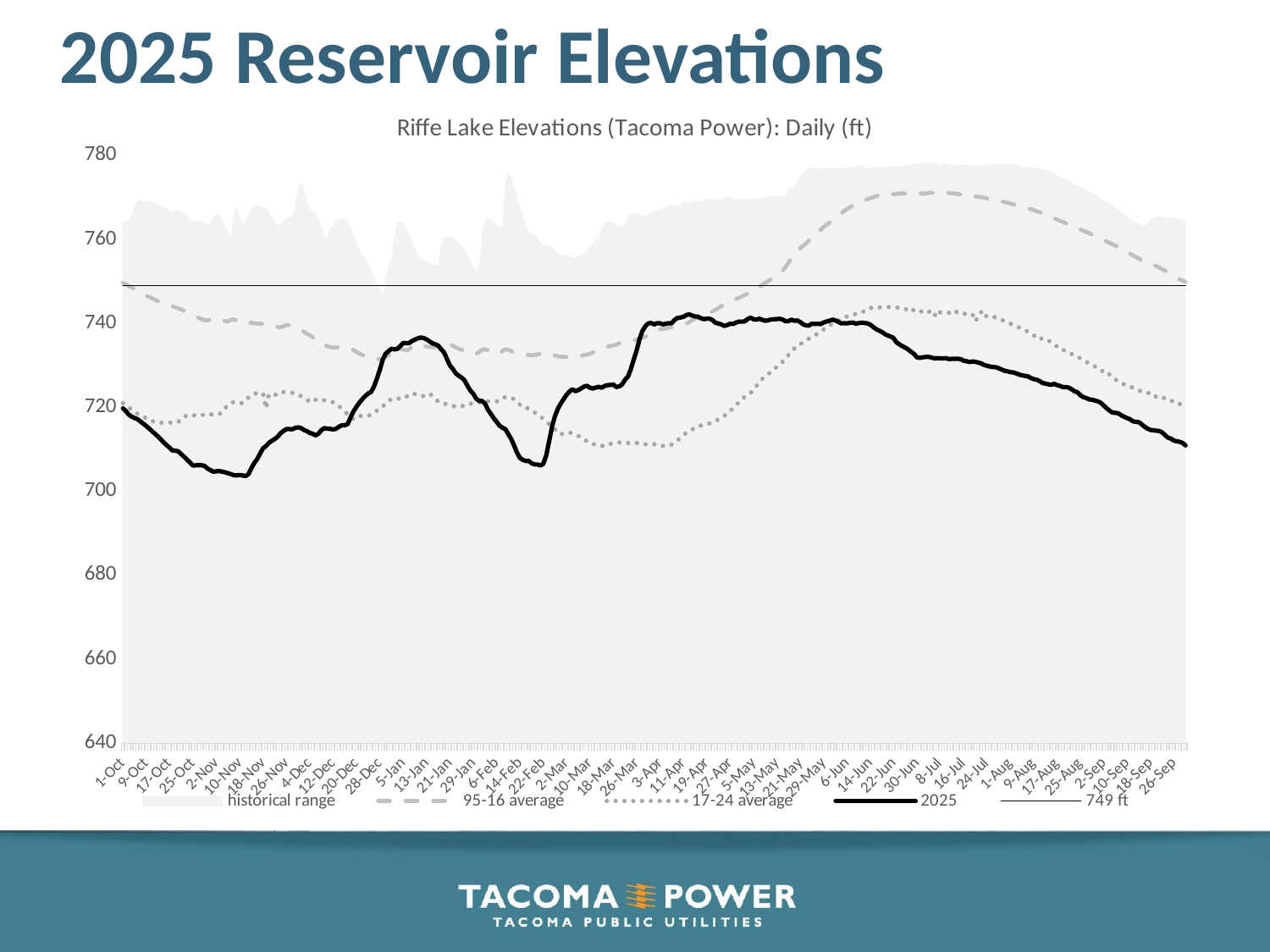
What elevation does the thin horizontal reference line in the legend represent? 749 ft What kind of chart is shown on the slide? line chart Is the 17-24 average elevation on 19-Apr greater or less than 720? less How many entries does the chart legend list? 5 Is the 95-16 average elevation on 22-Jun greater or less than 760? greater Is the 2025 elevation on 26-Sep greater or less than 720? less On 22-Jun, which is higher: the 2025 line or the 95-16 average line? 95-16 average What is the title of the chart? Riffe Lake Elevations (Tacoma Power): Daily (ft) Among the three line series (95-16 average, 17-24 average, 2025), which is highest on 22-Jun? 95-16 average On 10-Nov, which is higher: the 2025 line or the 17-24 average line? 17-24 average Does the 2025 line rise or fall between 14-Jun and 26-Sep? fall